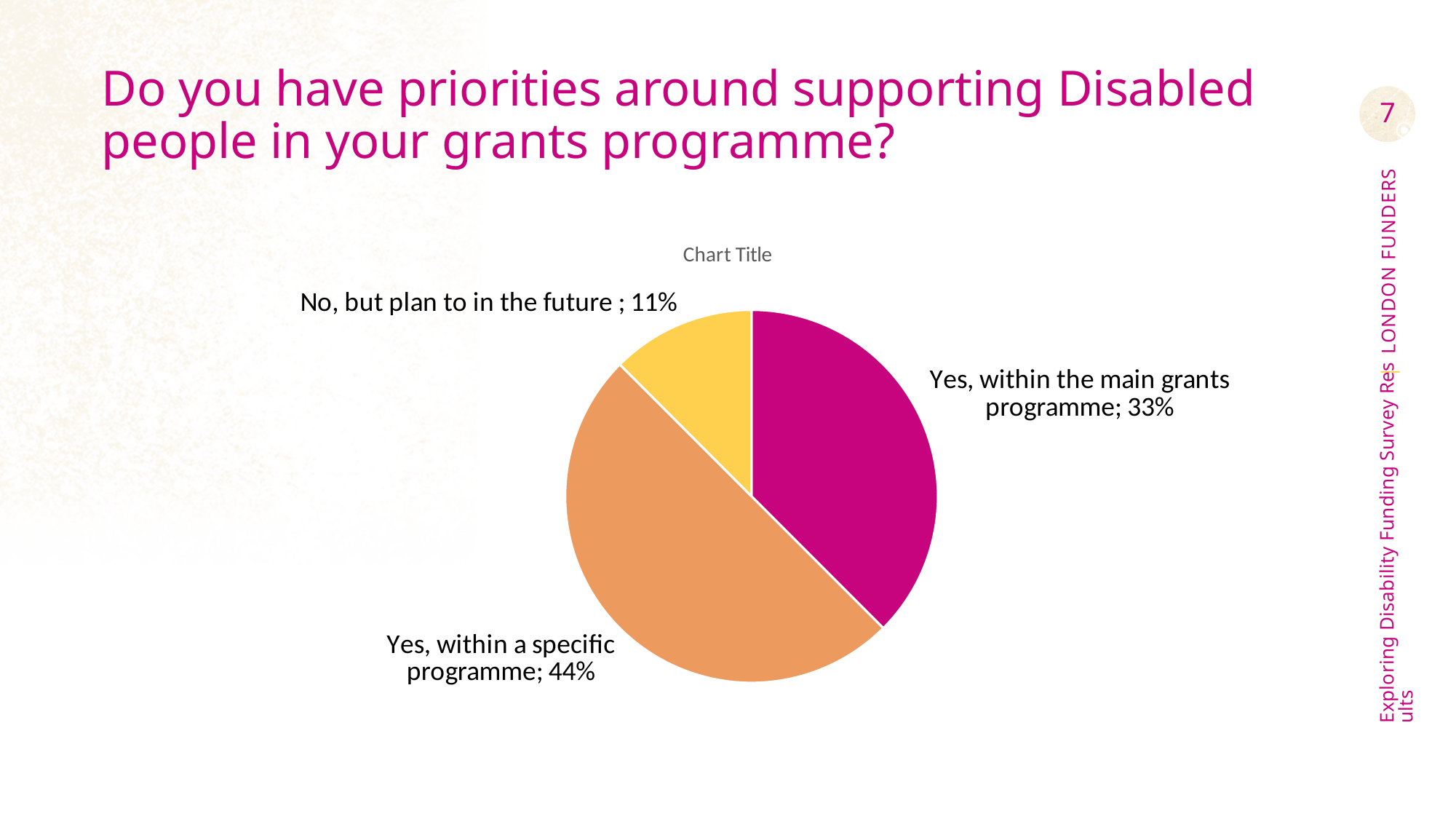
What share of the pie is 'No, but plan to in the future'? 11% Which is larger: the slice for 'Yes, within the main grants programme' or the slice for 'No, but plan to in the future'? Yes, within the main grants programme How many slices does the pie chart have? 3 What share of the pie is 'Yes, within a specific programme'? 44% Which category has the largest slice of the pie? Yes, within a specific programme What kind of chart is shown on the slide? Pie chart What colour is the slice for 'No, but plan to in the future'? Yellow What is the difference in percentage points between 'Yes, within a specific programme' and 'Yes, within the main grants programme'? 11 percentage points Which category has the smallest slice of the pie? No, but plan to in the future What is the difference in percentage points between 'Yes, within the main grants programme' and 'No, but plan to in the future'? 22 percentage points What share of the pie is 'Yes, within the main grants programme'? 33% What is the title printed above the pie chart? Chart Title